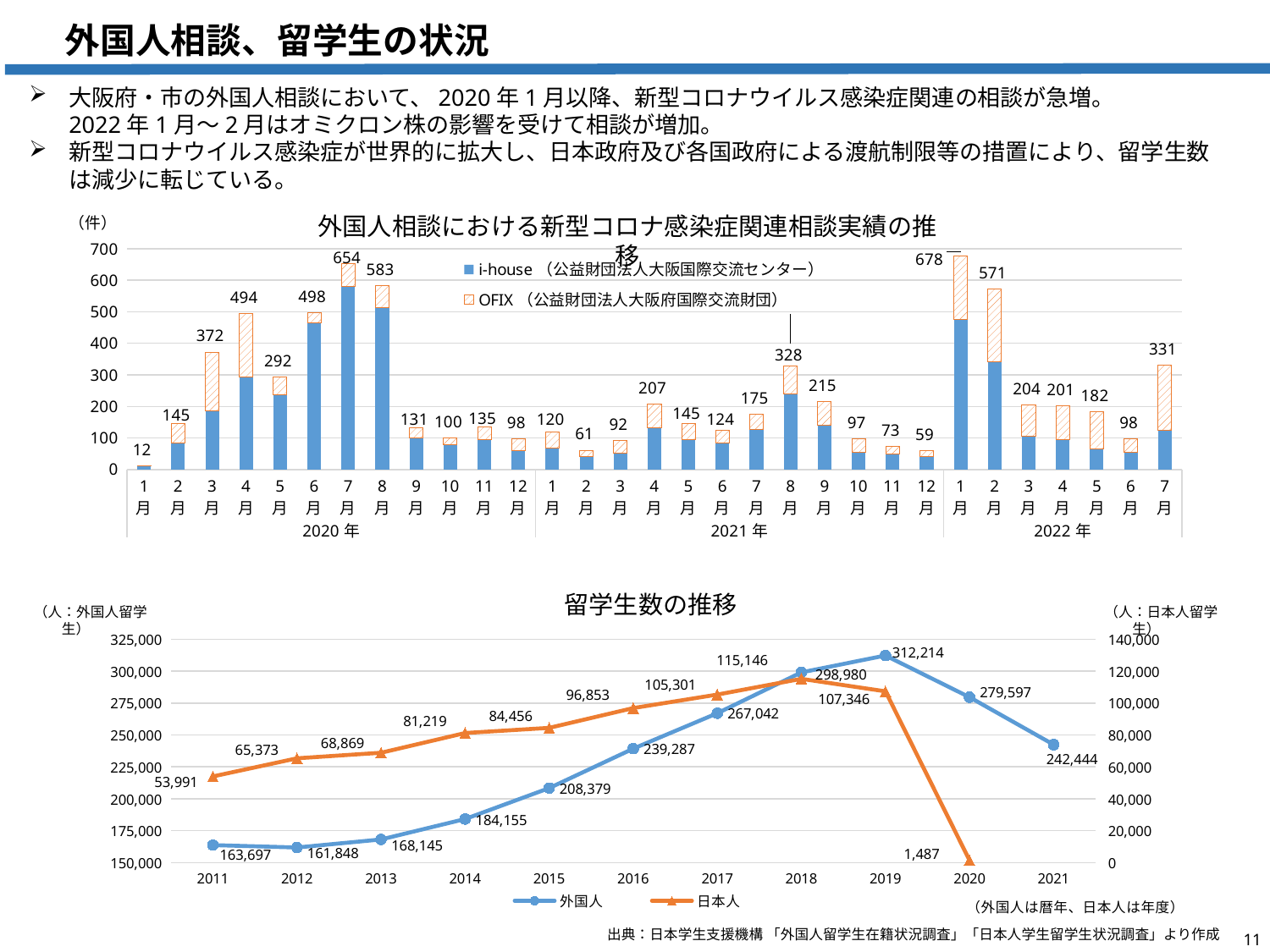
In the top chart (外国人相談における新型コロナ感染症関連相談実績の推移), what is the difference between the totals for January 2022 (678) and February 2022 (571)? 107 In the bottom chart (留学生数の推移), in which year does the foreign student (外国人) line reach its highest value? 2019 What kind of chart is the bottom chart (留学生数の推移)? Line chart In the bottom chart (留学生数の推移), which is larger for Japanese students (日本人): the 2018 value or the 2019 value? 2018 In the bottom chart (留学生数の推移), what is the difference between the foreign student (外国人) values for 2019 (312,214) and 2021 (242,444)? 69,770 In the top chart (外国人相談における新型コロナ感染症関連相談実績の推移), which month has the lowest total number of consultations? 2020年1月 What kind of chart is the top chart (外国人相談における新型コロナ感染症関連相談実績の推移)? Stacked bar chart In the top chart (外国人相談における新型コロナ感染症関連相談実績の推移), what is the total number of consultations labelled for July 2020 (2020年7月)? 654 In the top chart (外国人相談における新型コロナ感染症関連相談実績の推移), which month has the highest total number of consultations? 2022年1月 In the top chart (外国人相談における新型コロナ感染症関連相談実績の推移), how many series does the legend list? 2 In the bottom chart (留学生数の推移), what is the number of Japanese students (日本人) in 2020? 1,487 In the bottom chart (留学生数の推移), what is the number of foreign students (外国人) in 2019? 312,214